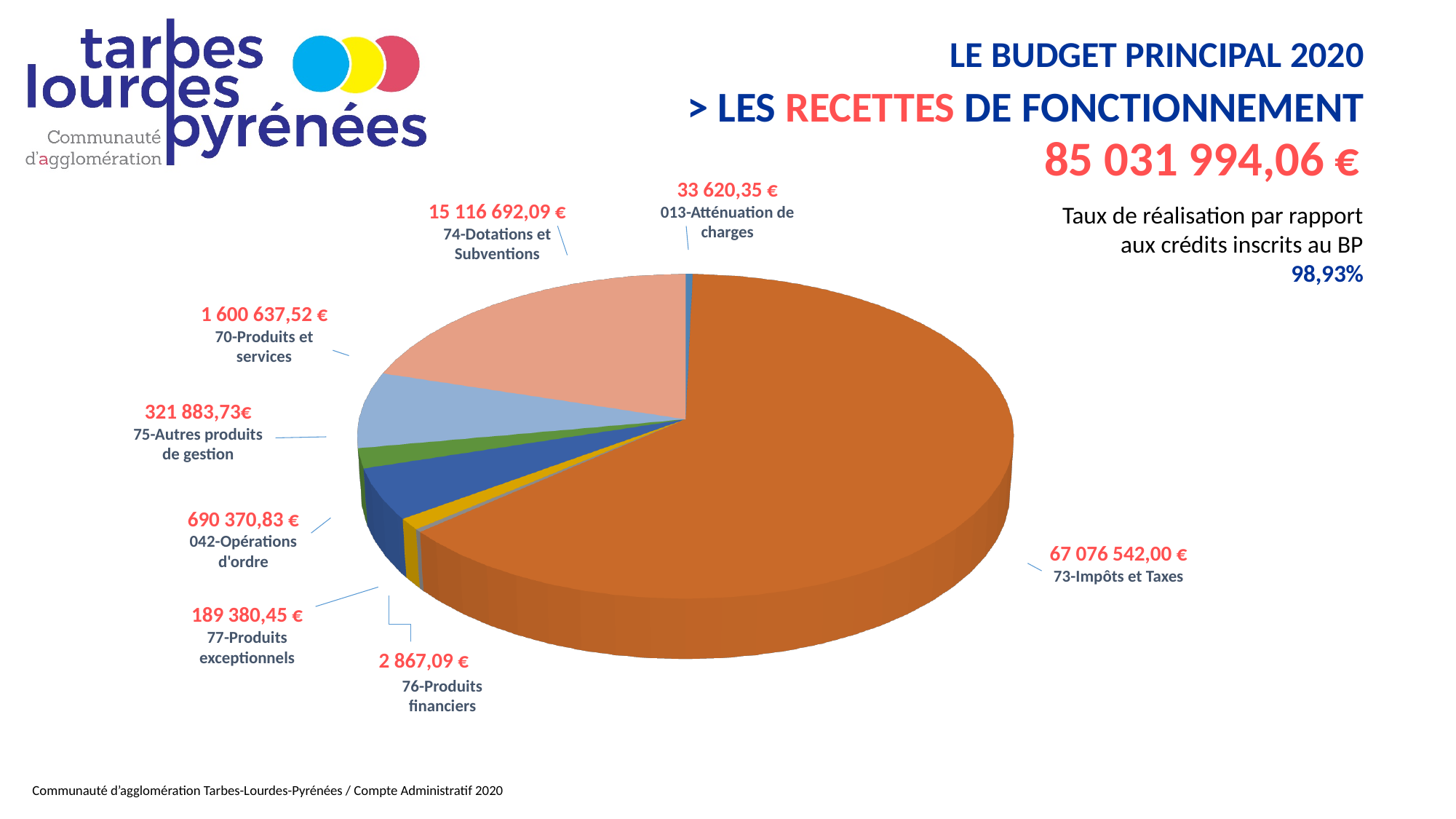
What kind of chart is shown on the slide? Pie chart What total amount of recettes de fonctionnement is shown on the slide? 85 031 994,06 € How many slices does the pie chart have? 8 What is the value for 013-Atténuation de charges? 33 620,35 € Which is larger, 75-Autres produits de gestion or 77-Produits exceptionnels? 75-Autres produits de gestion What is the value for 042-Opérations d'ordre? 690 370,83 € Which category has the smallest value? 76-Produits financiers What is the difference between 74-Dotations et Subventions and 70-Produits et services? 13 516 054,57 € What is the value for 73-Impôts et Taxes? 67 076 542,00 € What is the value for 76-Produits financiers? 2 867,09 € What is the value for 74-Dotations et Subventions? 15 116 692,09 € Which category has the largest slice of the pie? 73-Impôts et Taxes